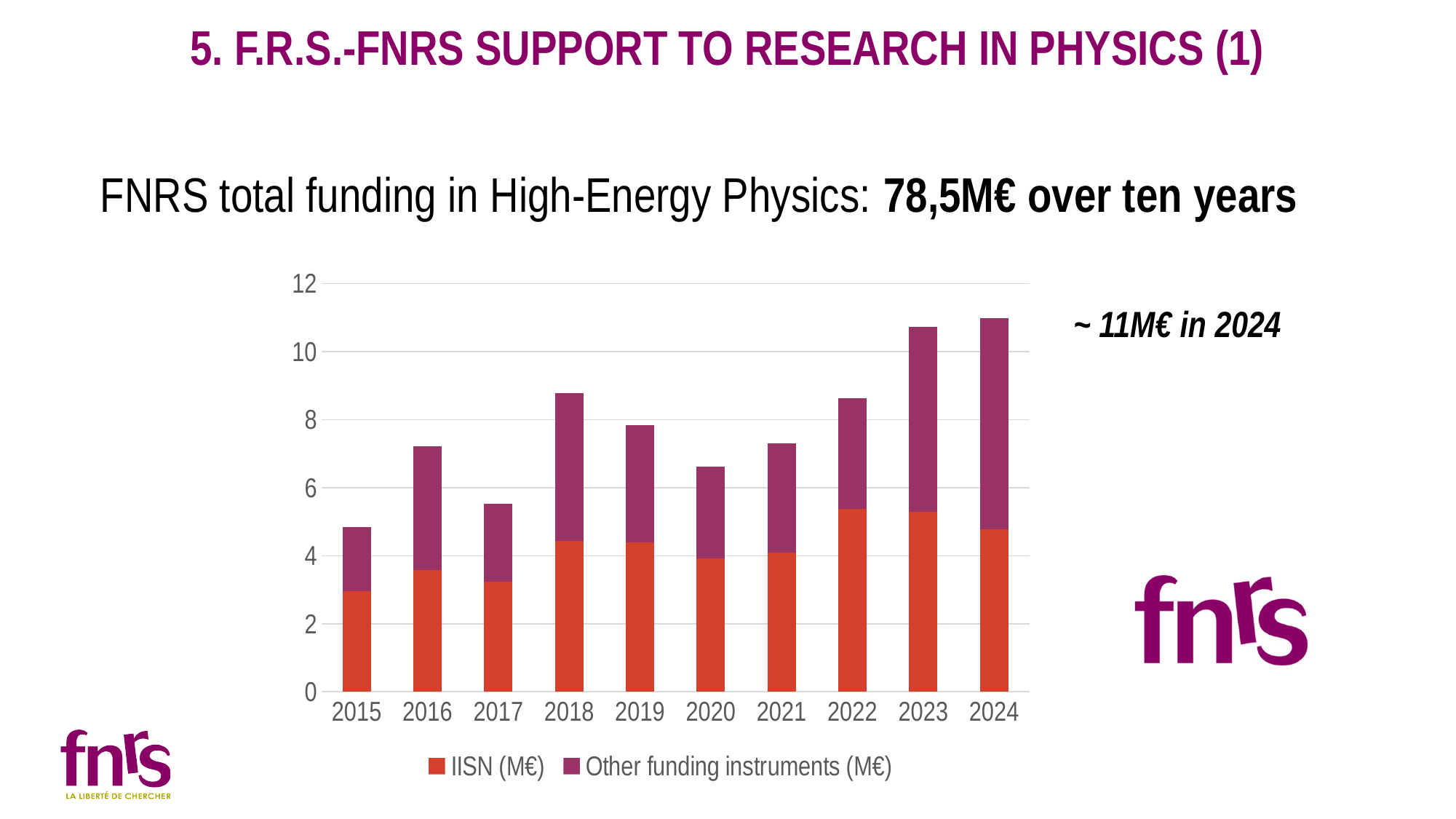
Is the IISN (M€) value for 2022 greater or less than 4? greater How many series does the chart's legend list? 2 How many years are shown on the x axis of the chart? 10 Is the total bar for 2024 greater or less than 10? greater What are the two series named in the chart's legend? IISN (M€) and Other funding instruments (M€) Which year has the larger total bar, 2018 or 2019? 2018 Is the total bar for 2015 greater or less than 6? less What kind of chart is shown on the slide? Stacked bar chart Overall, do the total bars rise or fall from 2015 to 2024? rise Which year has the lowest total bar in the chart? 2015 Which year has the highest total bar in the chart? 2024